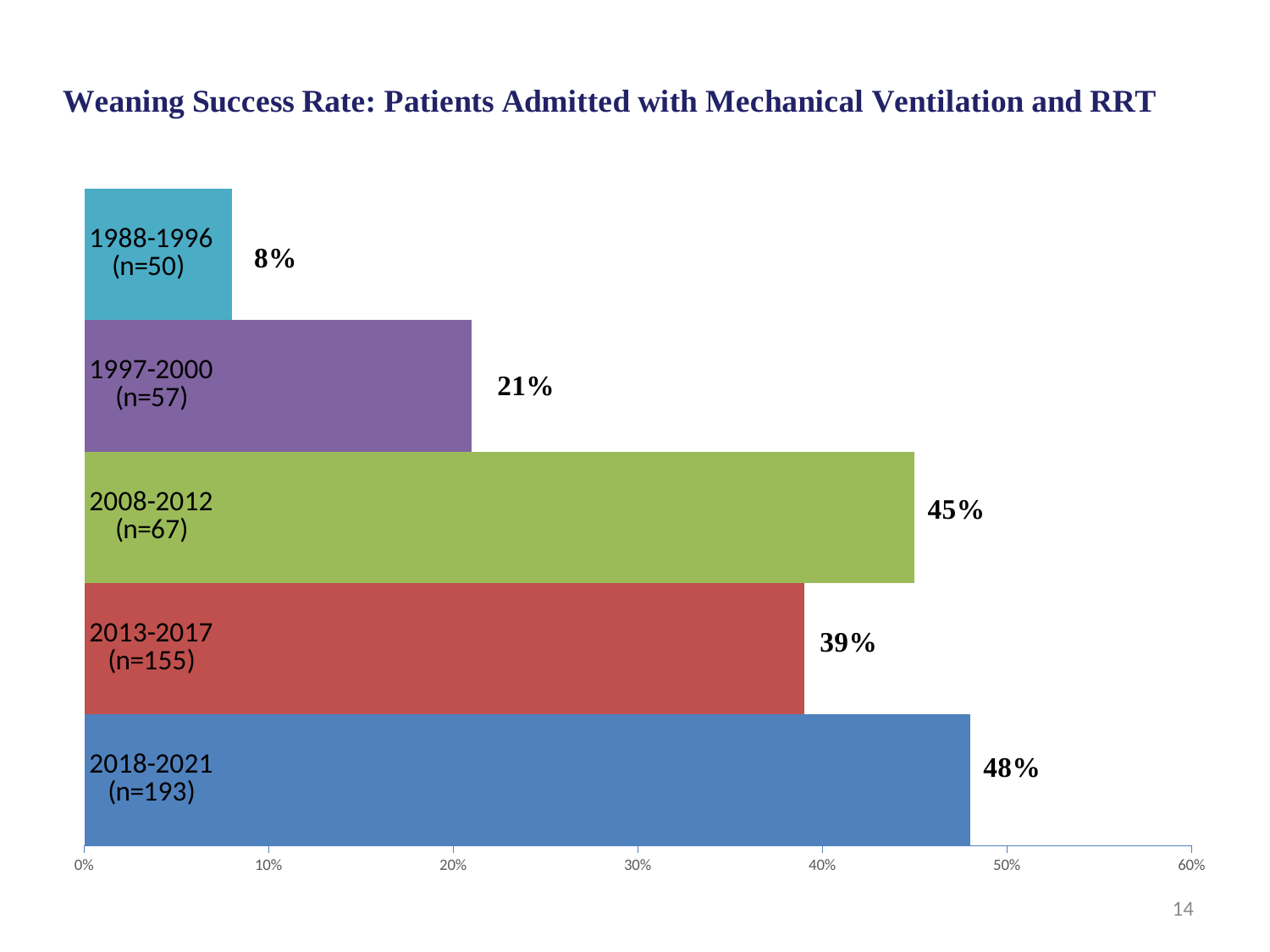
What is the weaning success rate for the 2008-2012 (n=67) period? 45% What is the weaning success rate for the 2013-2017 (n=155) period? 39% Which period has the highest weaning success rate? 2018-2021 (n=193) Which period has the lowest weaning success rate? 1988-1996 (n=50) What is the difference in weaning success rate between the 2018-2021 period and the 1988-1996 period? 40% Is the weaning success rate for the 2018-2021 period greater or less than 40%? greater Which period has a higher weaning success rate, 1997-2000 or 2013-2017? 2013-2017 What kind of chart is shown on the slide? Bar chart How many time periods are shown in the chart? 5 What is the title of the chart? Weaning Success Rate: Patients Admitted with Mechanical Ventilation and RRT What is the weaning success rate for the 1988-1996 (n=50) period? 8% What is the difference in weaning success rate between the 2008-2012 period and the 2013-2017 period? 6%